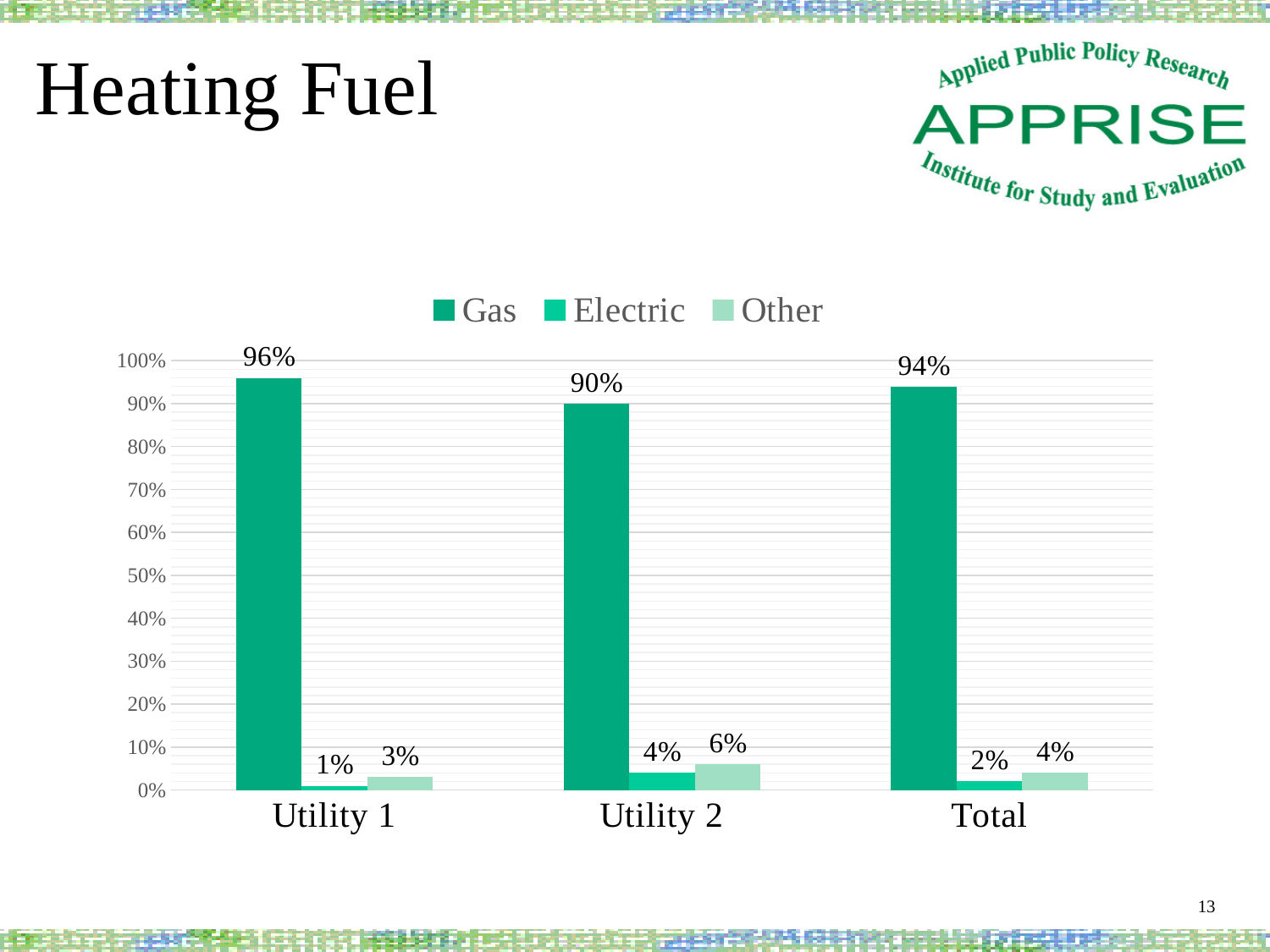
Which is larger, the Other value for Utility 2 or the Other value for Utility 1? Utility 2 Is the Gas value for Utility 2 greater or less than 80%? greater What is the Gas value for Utility 1? 96% What is the difference between the Gas values for Utility 1 and Utility 2? 6% What kind of chart is shown on the slide? bar chart Which category has the lowest Electric value? Utility 1 How many series does the legend list? 3 How many categories are shown on the x axis? 3 What is the Electric value for Utility 2? 4% What is the Other value for Total? 4% What is the title of the slide? Heating Fuel Which category has the highest Gas value? Utility 1